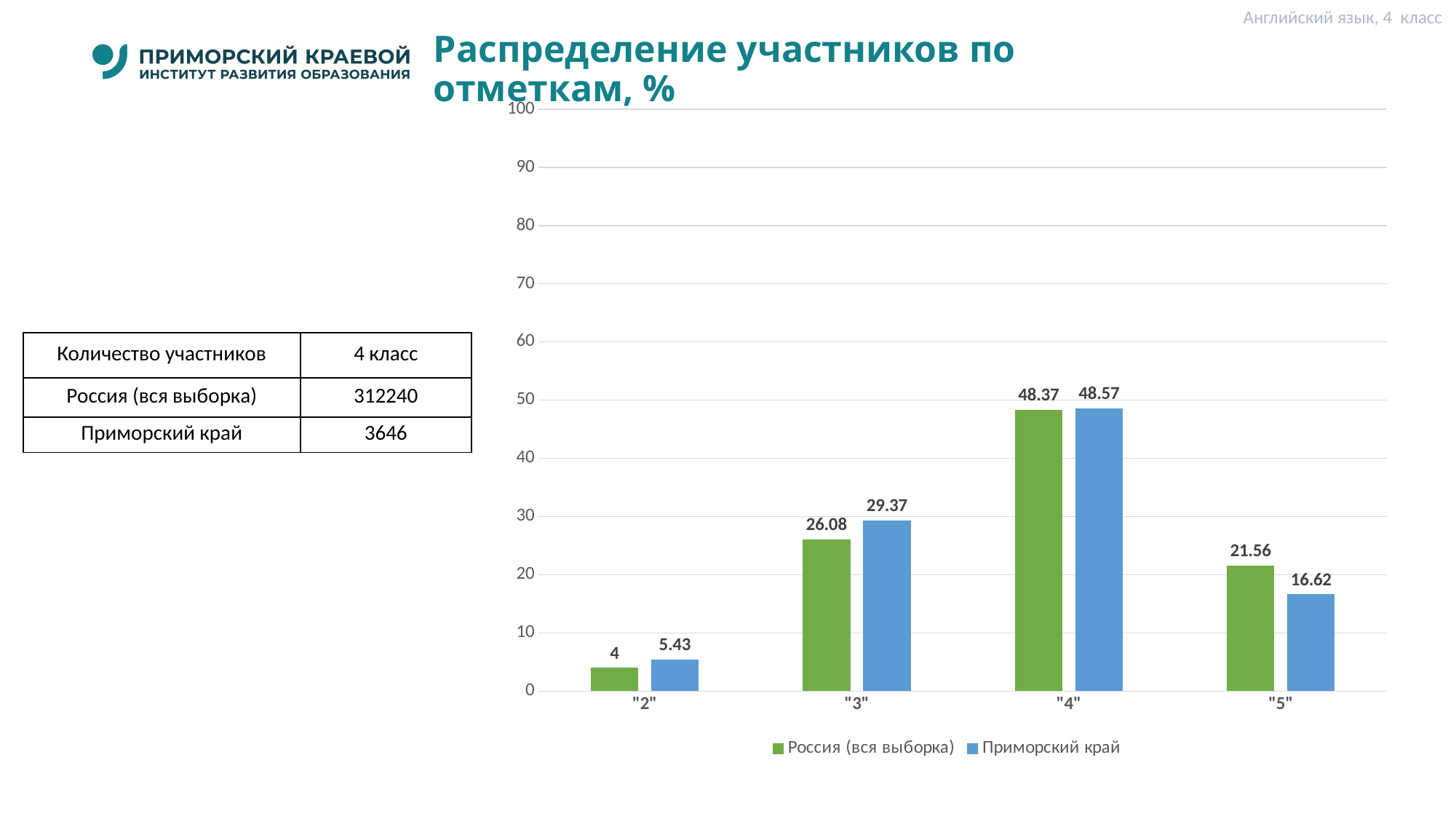
Is the value for Приморский край at mark "5" greater or less than 20? less Which mark has the highest value for Приморский край? "4" What is the difference between Приморский край and Россия (вся выборка) at mark "3"? 3.29 What is the value for Приморский край at mark "3"? 29.37 Which mark has the lowest value for Россия (вся выборка)? "2" What kind of chart is shown on the slide? bar chart Which colour represents Приморский край in the chart? blue How many mark categories are shown on the x axis? 4 What is the value for Россия (вся выборка) at mark "5"? 21.56 How many series does the legend list? 2 At mark "5", which series has the larger value: Россия (вся выборка) or Приморский край? Россия (вся выборка) What is the value for Россия (вся выборка) at mark "2"? 4